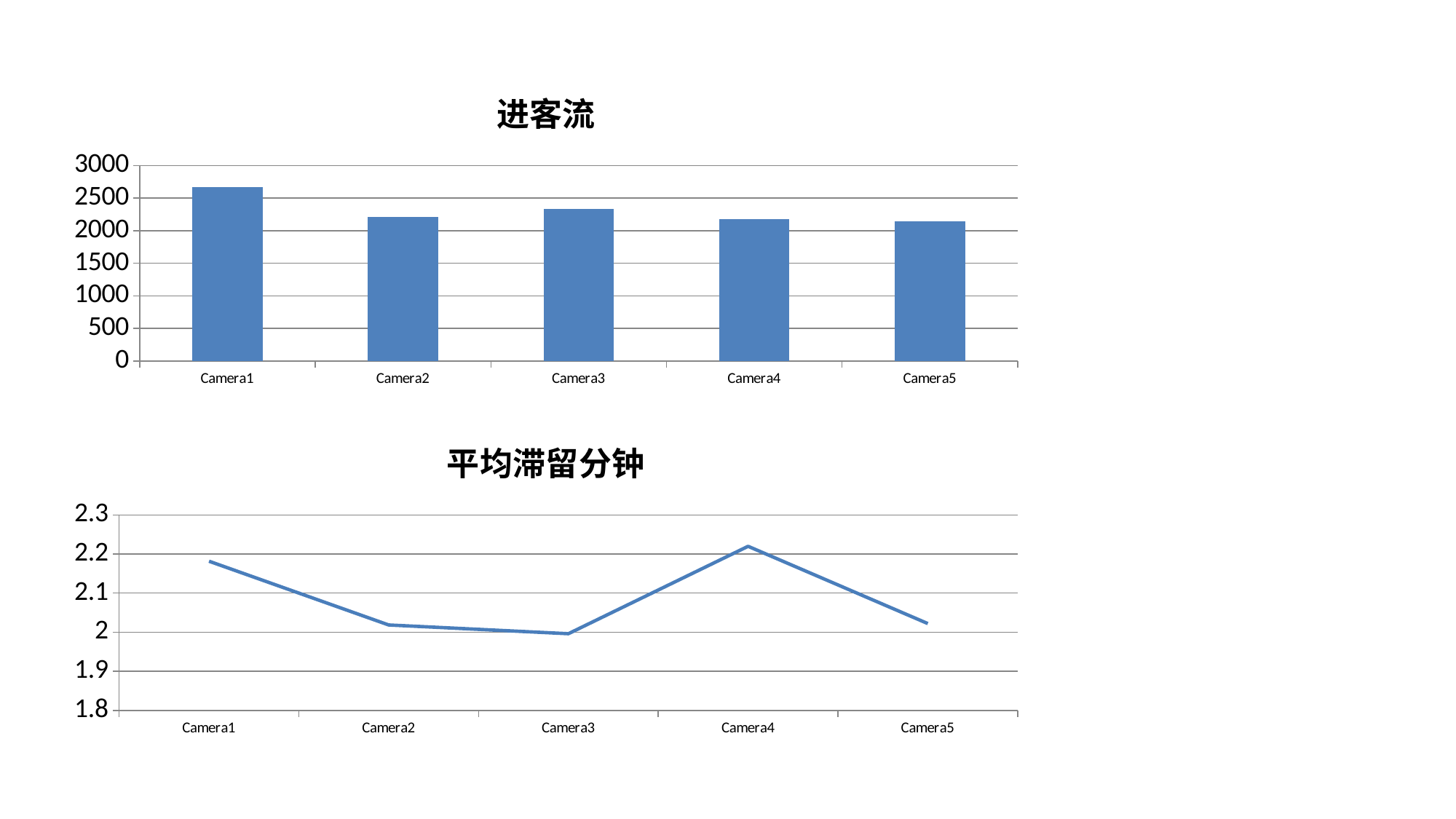
What kind of chart is the top chart titled 进客流? bar chart In the 进客流 chart, which camera has the highest value? Camera1 In the 平均滞留分钟 chart, which camera has the highest value? Camera4 In the 进客流 chart, which is larger, the value for Camera1 or the value for Camera3? Camera1 In the 进客流 chart, how many cameras are shown on the x axis? 5 In the 平均滞留分钟 chart, do the values rise or fall from Camera1 to Camera3? fall In the 进客流 chart, is the value for Camera1 greater or less than 2500? greater In the 平均滞留分钟 chart, is the value for Camera3 greater or less than 2.1? less In the 平均滞留分钟 chart, is the value for Camera1 greater or less than 2.1? greater What kind of chart is the bottom chart titled 平均滞留分钟? line chart